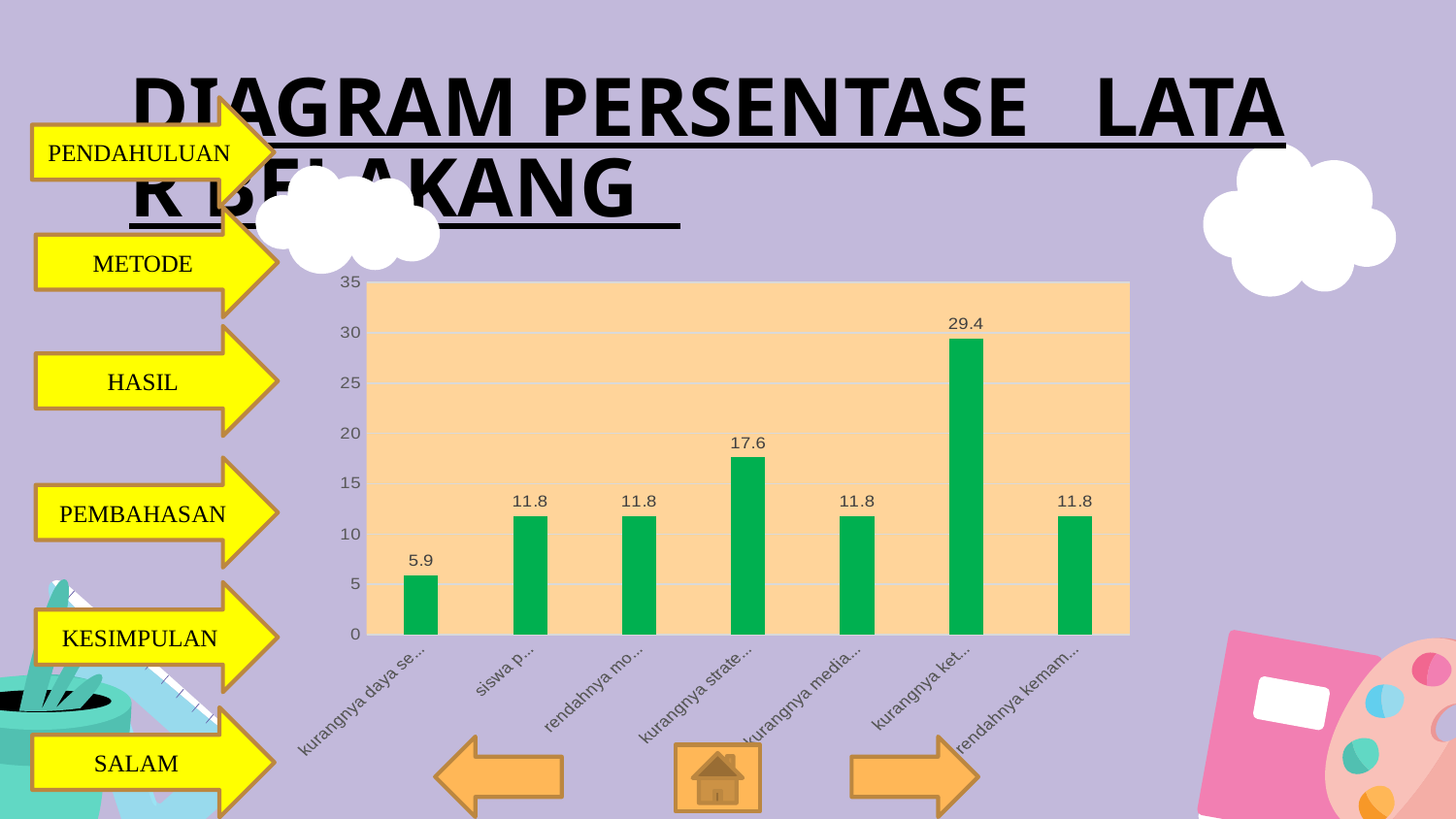
What is the value of the sixth bar from the left (labelled "kurangnya ket...")? 29.4 Is the value of the sixth bar (kurangnya ket...) greater or less than 25? greater How many bars are plotted in the chart? 7 What type of chart is shown on the slide? bar chart Which bar has the highest value? the sixth bar (kurangnya ket...) Which is larger, the value of the fourth bar (kurangnya strate...) or the value of the fifth bar (kurangnya media...)? the fourth bar (kurangnya strate...) What is the value of the first bar from the left (labelled "kurangnya daya se...")? 5.9 Which bar has the lowest value? the first bar (kurangnya daya se...) How many bars have the value 11.8? 4 What is the value of the fourth bar from the left (labelled "kurangnya strate...")? 17.6 What is the value of the second bar from the left (labelled "siswa p...")? 11.8 What is the difference between the highest bar value and the lowest bar value? 23.5